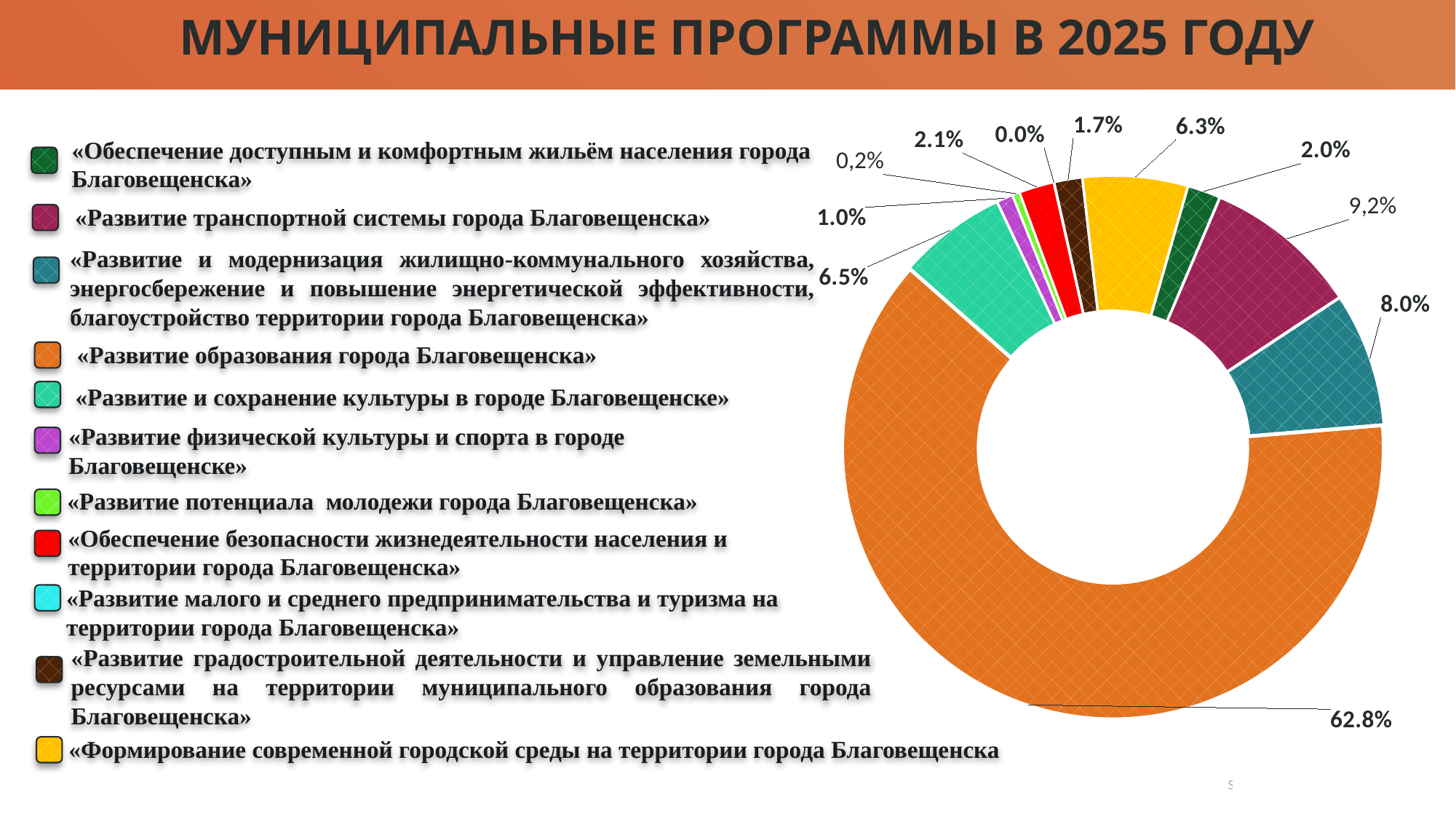
Which has a larger share: «Развитие и сохранение культуры в городе Благовещенске» or «Формирование современной городской среды на территории города Благовещенска»? «Развитие и сохранение культуры в городе Благовещенске» How many programs are listed in the chart legend? 11 What share is shown for «Развитие и сохранение культуры в городе Благовещенске»? 6.5% What share is shown for «Формирование современной городской среды на территории города Благовещенска»? 6.3% Which program has the smallest share of the chart? «Развитие малого и среднего предпринимательства и туризма на территории города Благовещенска» What share is shown for «Развитие транспортной системы города Благовещенска»? 9,2% What type of chart is shown on the slide? Doughnut (pie) chart Which program has the largest share of the chart? «Развитие образования города Благовещенска» What is the difference between the shares of «Развитие транспортной системы города Благовещенска» (9,2%) and «Развитие и модернизация жилищно-коммунального хозяйства...» (8.0%)? 1.2% What share of the chart does «Развитие образования города Благовещенска» have? 62.8% What share is shown for «Развитие и модернизация жилищно-коммунального хозяйства...»? 8.0% What share is shown for «Обеспечение доступным и комфортным жильём населения города Благовещенска»? 2.0%